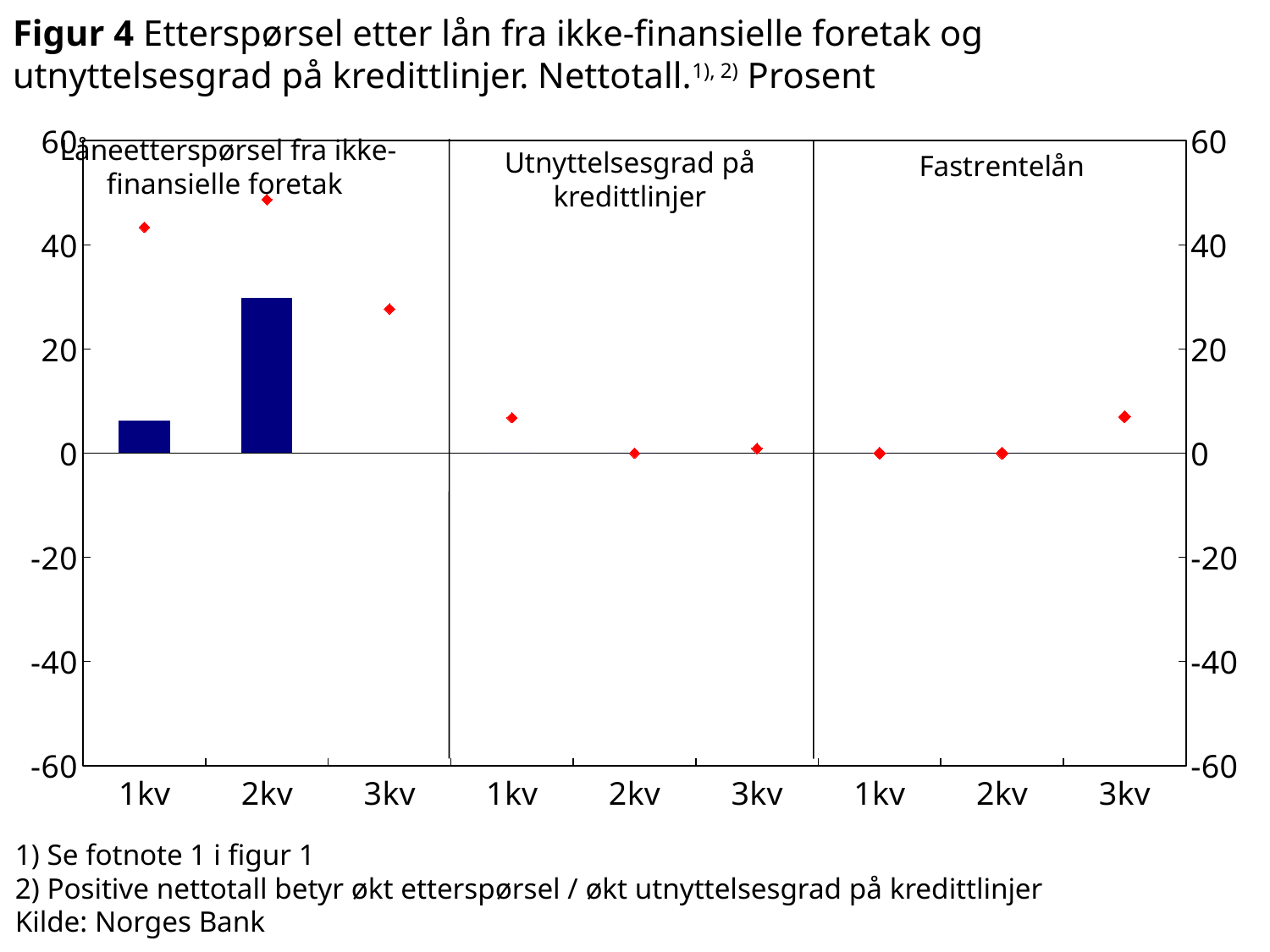
What kind of chart is shown on the slide? combination chart with bars and diamond markers In the panel 'Utnyttelsesgrad på kredittlinjer', is the red diamond for 1kv greater or less than 20? less In the panel 'Låneetterspørsel fra ikke-finansielle foretak', is the red diamond for 2kv greater or less than 40? greater How many panels does the chart have? 3 In the panel 'Låneetterspørsel fra ikke-finansielle foretak', is the bar for 1kv greater or less than 20? less What is the title of the rightmost panel of the chart? Fastrentelån How many quarters are shown on the x axis of each panel? 3 In the panel 'Fastrentelån', which red diamond is higher, 1kv or 3kv? 3kv In the panel 'Låneetterspørsel fra ikke-finansielle foretak', which quarter has the highest red diamond? 2kv In the panel 'Låneetterspørsel fra ikke-finansielle foretak', which bar is taller, 1kv or 2kv? 2kv